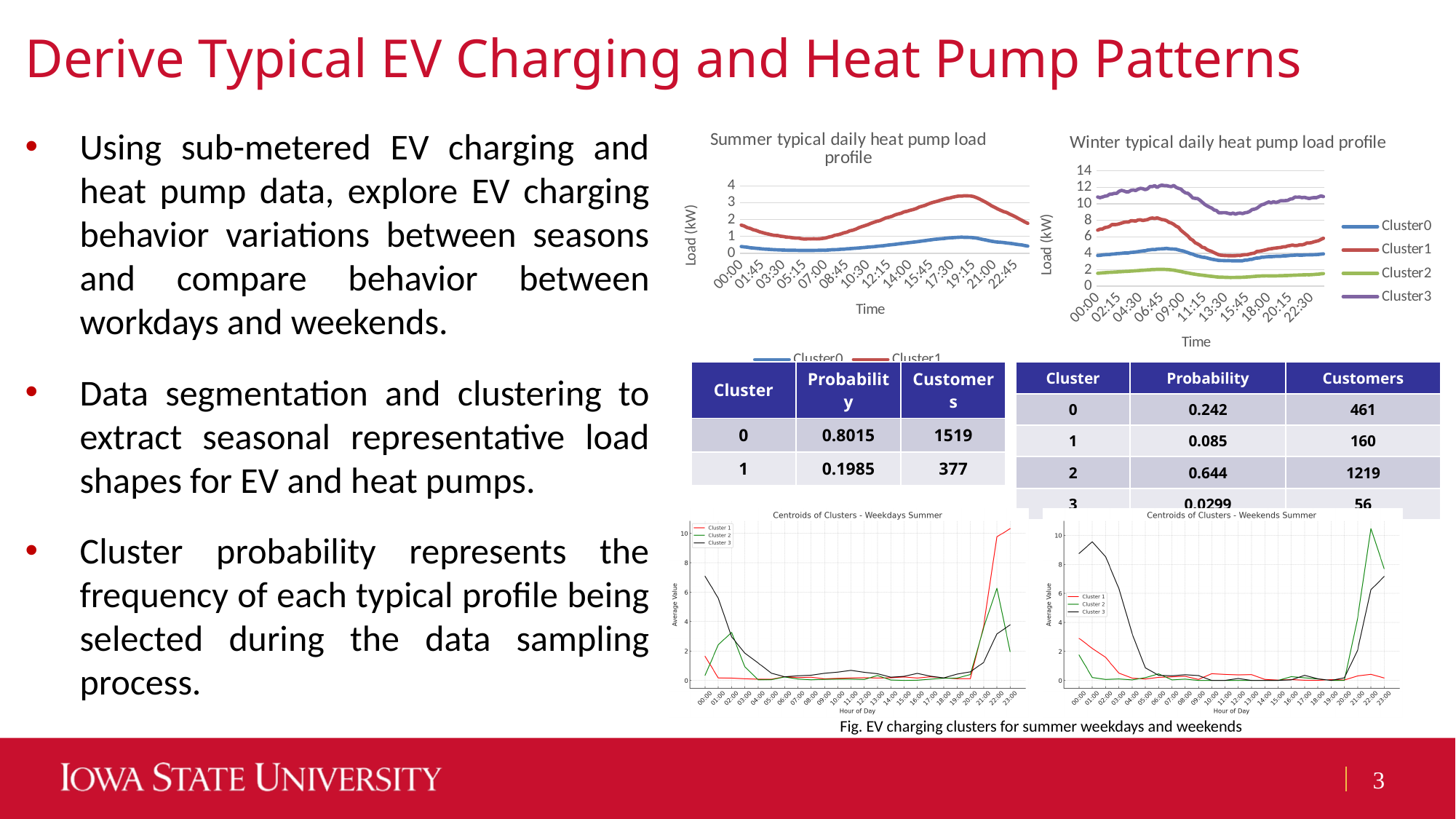
How many series does the legend of the 'Summer typical daily heat pump load profile' chart list? 2 What kind of chart is the 'Winter typical daily heat pump load profile'? line chart In the 'Winter typical daily heat pump load profile' chart, which cluster has the lowest load throughout the day? Cluster2 In the 'Winter typical daily heat pump load profile' chart, is the value for Cluster3 at 00:00 greater or less than 10? greater In the 'Summer typical daily heat pump load profile' chart, is the peak value of Cluster1 around 19:15 greater or less than 3? greater What is the y-axis label of the 'Centroids of Clusters - Weekdays Summer' chart? Average Value How many series does the legend of the 'Winter typical daily heat pump load profile' chart list? 4 In the 'Centroids of Clusters - Weekdays Summer' chart, is the value for Cluster 1 at 23:00 greater or less than 10? greater In the 'Summer typical daily heat pump load profile' chart, does the Cluster1 load rise or fall between 07:00 and 19:15? rise In the 'Centroids of Clusters - Weekends Summer' chart, which cluster has the highest value at 22:00? Cluster 2 In the 'Winter typical daily heat pump load profile' chart, which cluster has the highest load throughout the day? Cluster3 In the 'Summer typical daily heat pump load profile' chart, which series has the higher load at 19:15, Cluster0 or Cluster1? Cluster1